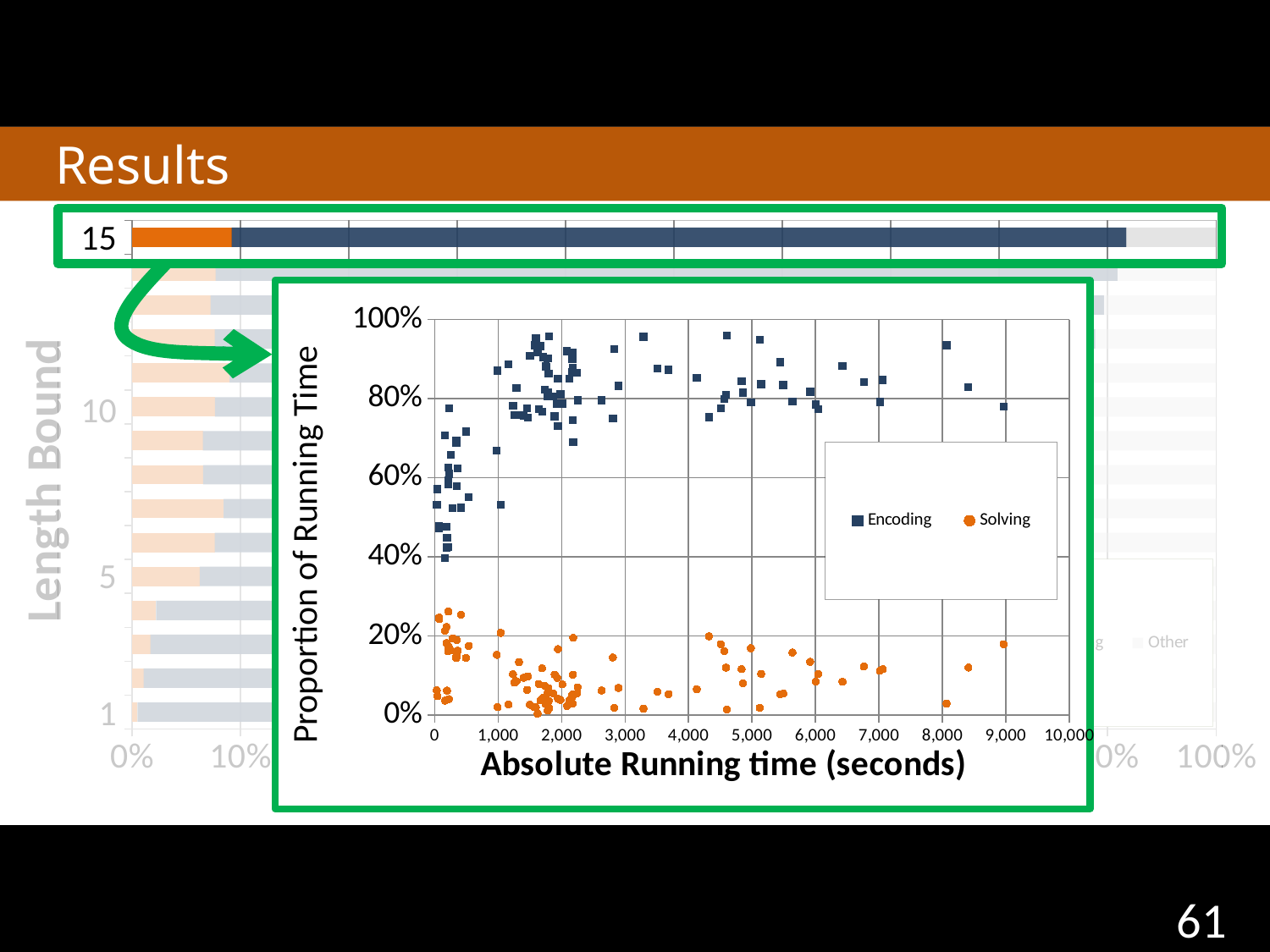
In the scatter chart, is the highest Encoding point greater or less than 80%? greater What is the title of the vertical axis of the scatter chart? Proportion of Running Time What are the two series named in the legend of the scatter chart? Encoding and Solving In the scatter chart, are the Solving points greater or less than 40% on the vertical axis? less What kind of chart is the chart in the green box titled with axis 'Absolute Running time (seconds)'? scatter chart In the scatter chart, is the lowest Encoding point greater or less than 20%? greater What is the maximum value shown on the horizontal axis of the scatter chart? 10,000 In the scatter chart, which series has the higher proportion of running time, Encoding or Solving? Encoding How many series does the legend of the scatter chart list? 2